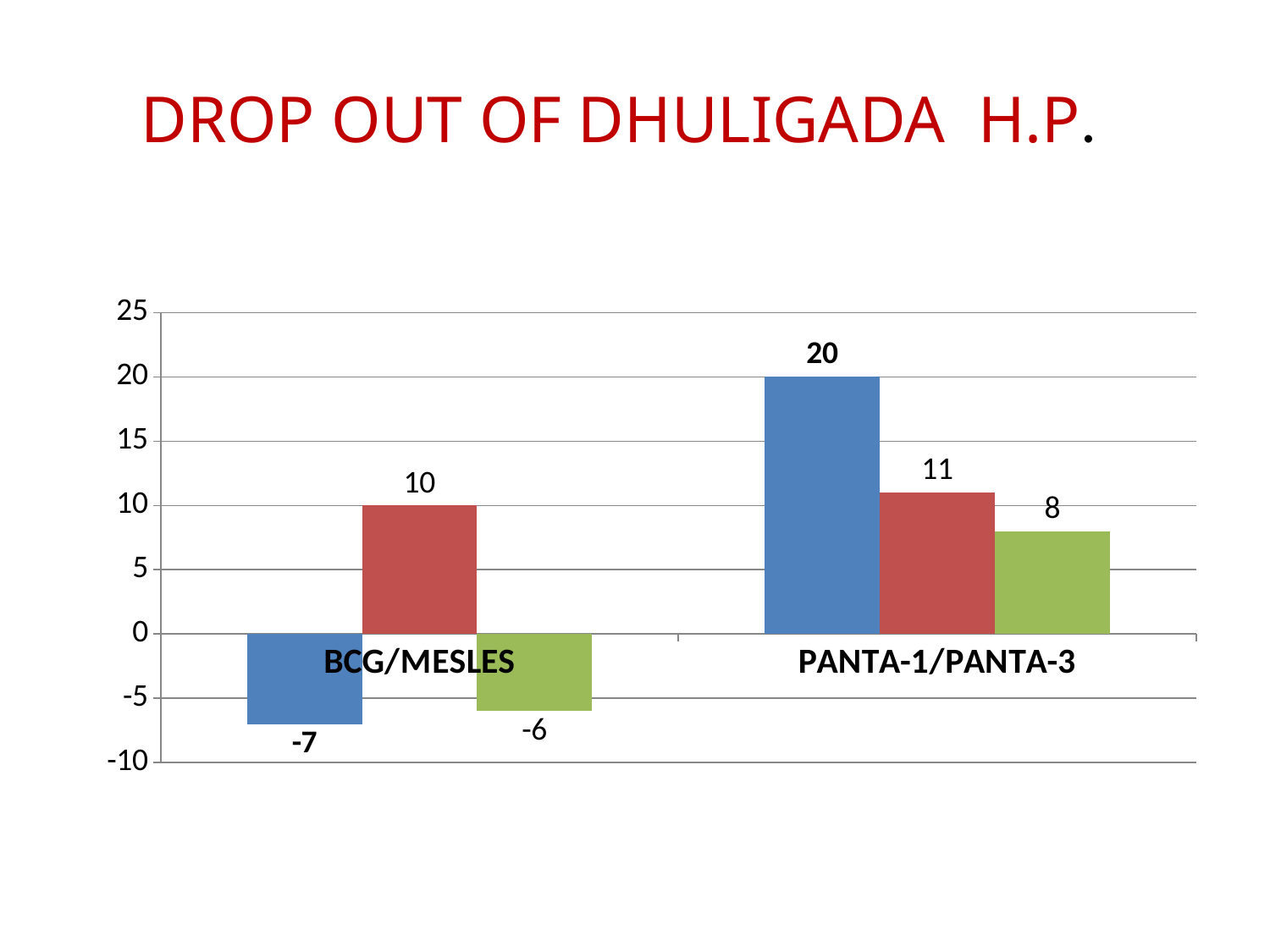
What is the value of the green bar for BCG/MESLES? -6 What is the value of the green bar for PANTA-1/PANTA-3? 8 What is the title of the slide? DROP OUT OF DHULIGADA H.P. Which bar has the highest value on the chart? The blue bar for PANTA-1/PANTA-3 (20) What kind of chart is shown on the slide? Bar chart What is the value of the red bar for BCG/MESLES? 10 How many categories are shown on the x axis? 2 What is the value of the blue bar for BCG/MESLES? -7 Which is larger, the red bar for PANTA-1/PANTA-3 or the red bar for BCG/MESLES? The red bar for PANTA-1/PANTA-3 Which bar has the lowest value on the chart? The blue bar for BCG/MESLES (-7) What is the value of the blue bar for PANTA-1/PANTA-3? 20 What is the difference between the blue bar and the red bar for PANTA-1/PANTA-3? 9